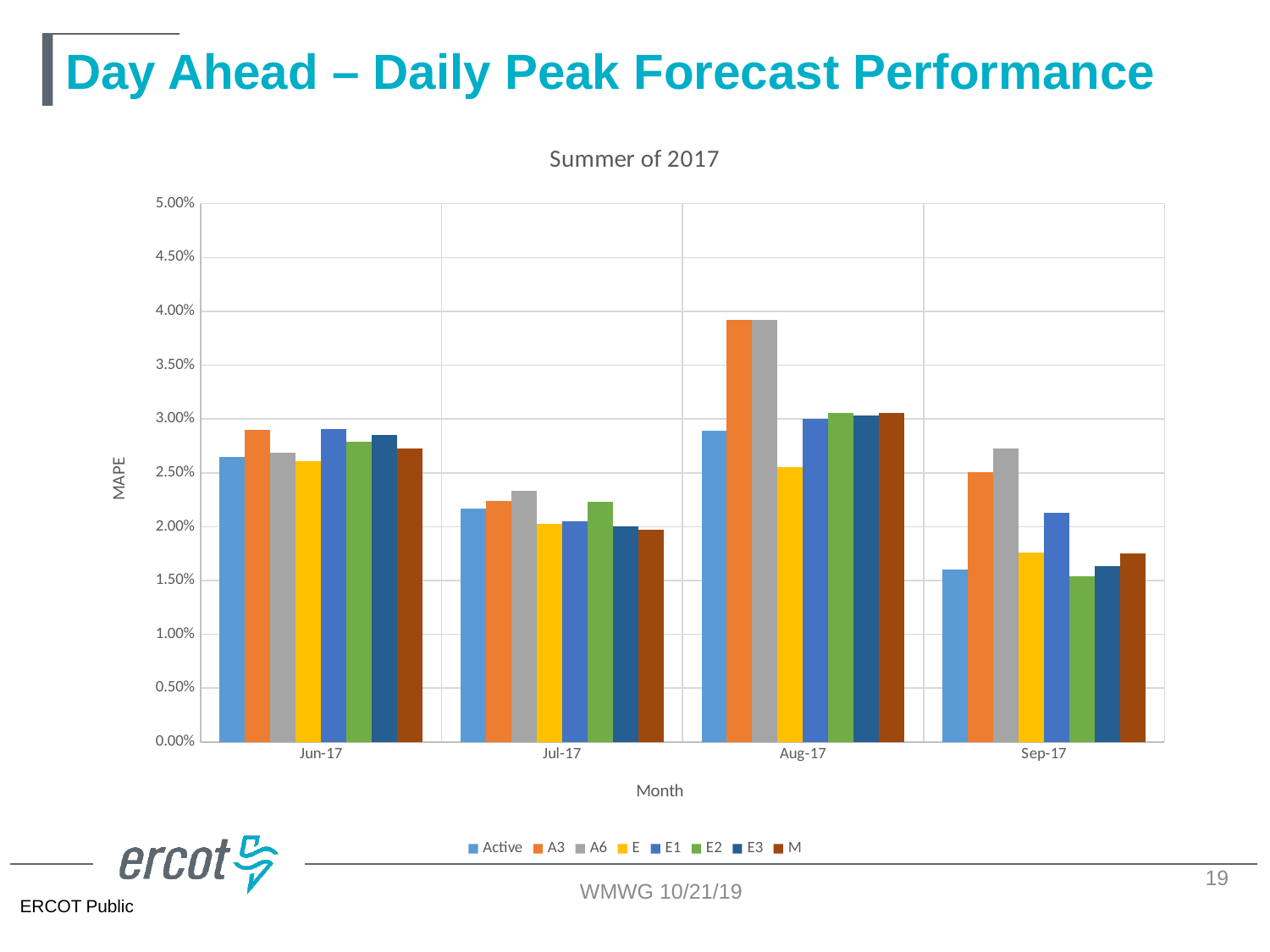
Is the value for E in Sep-17 greater or less than 2.00%? less What is the label on the y axis? MAPE How many series does the legend list? 8 How many months are shown on the x axis? 4 Is the value for Active in Aug-17 greater or less than 3.00%? less Is the value for A6 in Sep-17 greater or less than 2.50%? greater In which month is the Active value lowest? Sep-17 What kind of chart is shown on the slide? bar chart In Jul-17, which is larger, A6 or E? A6 Which series has the highest value in Sep-17? A6 In which month is the A3 value highest? Aug-17